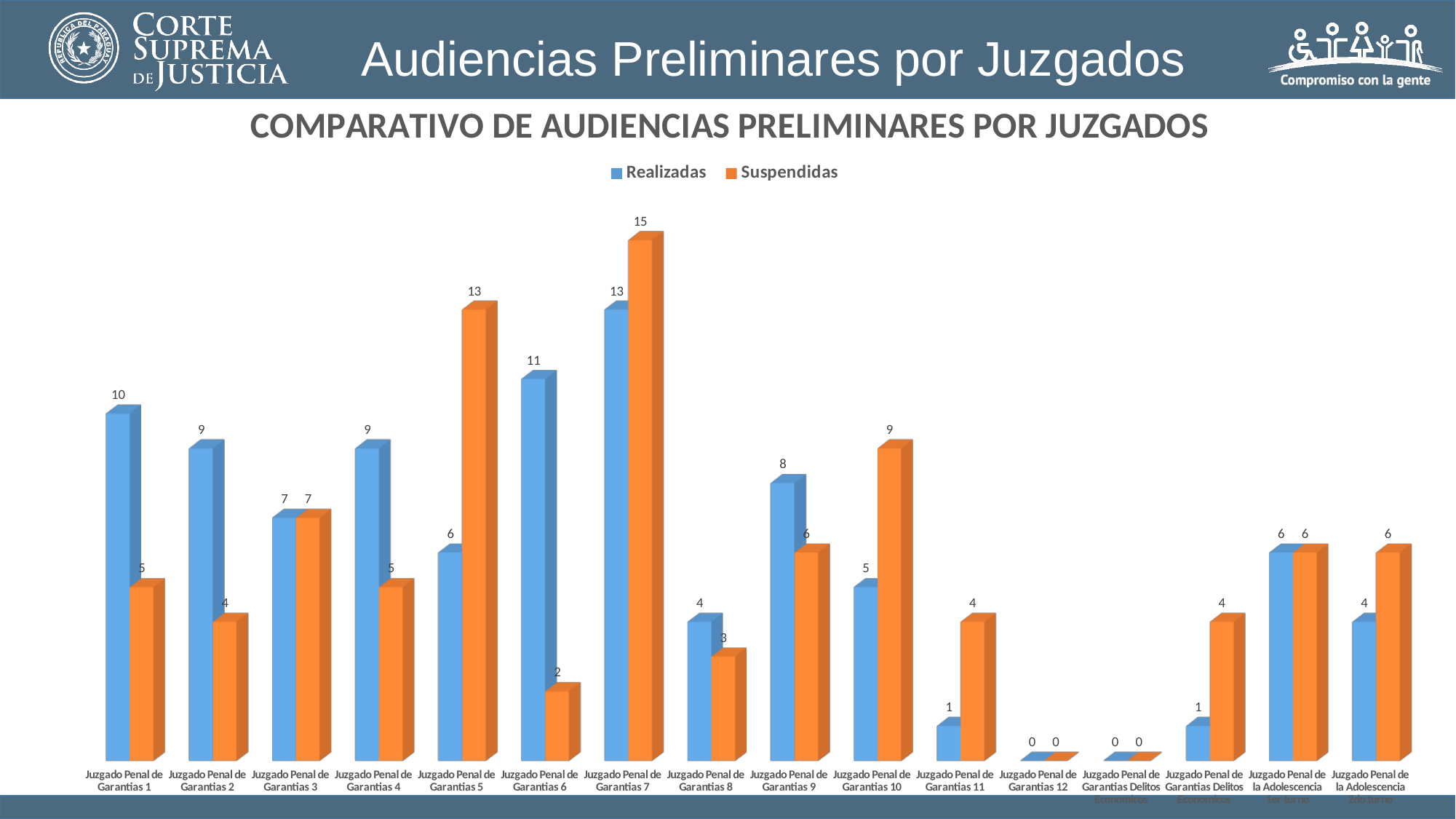
How many juzgados (categories) are shown on the x axis? 16 How many series does the legend list? 2 What is the value of Suspendidas for Juzgado Penal de Garantias 5? 13 What is the value of Realizadas for Juzgado Penal de Garantias 6? 11 What is the total of Realizadas and Suspendidas for Juzgado Penal de Garantias 9? 14 What kind of chart is shown on the slide? Bar chart Which juzgado has the highest Realizadas value? Juzgado Penal de Garantias 7 Which is larger for Juzgado Penal de Garantias 10, Realizadas or Suspendidas? Suspendidas What is the difference between Suspendidas and Realizadas for Juzgado Penal de Garantias 7? 2 What is the title of the chart? COMPARATIVO DE AUDIENCIAS PRELIMINARES POR JUZGADOS Which juzgado has the highest Suspendidas value? Juzgado Penal de Garantias 7 What is the value of Realizadas for Juzgado Penal de Garantias 1? 10